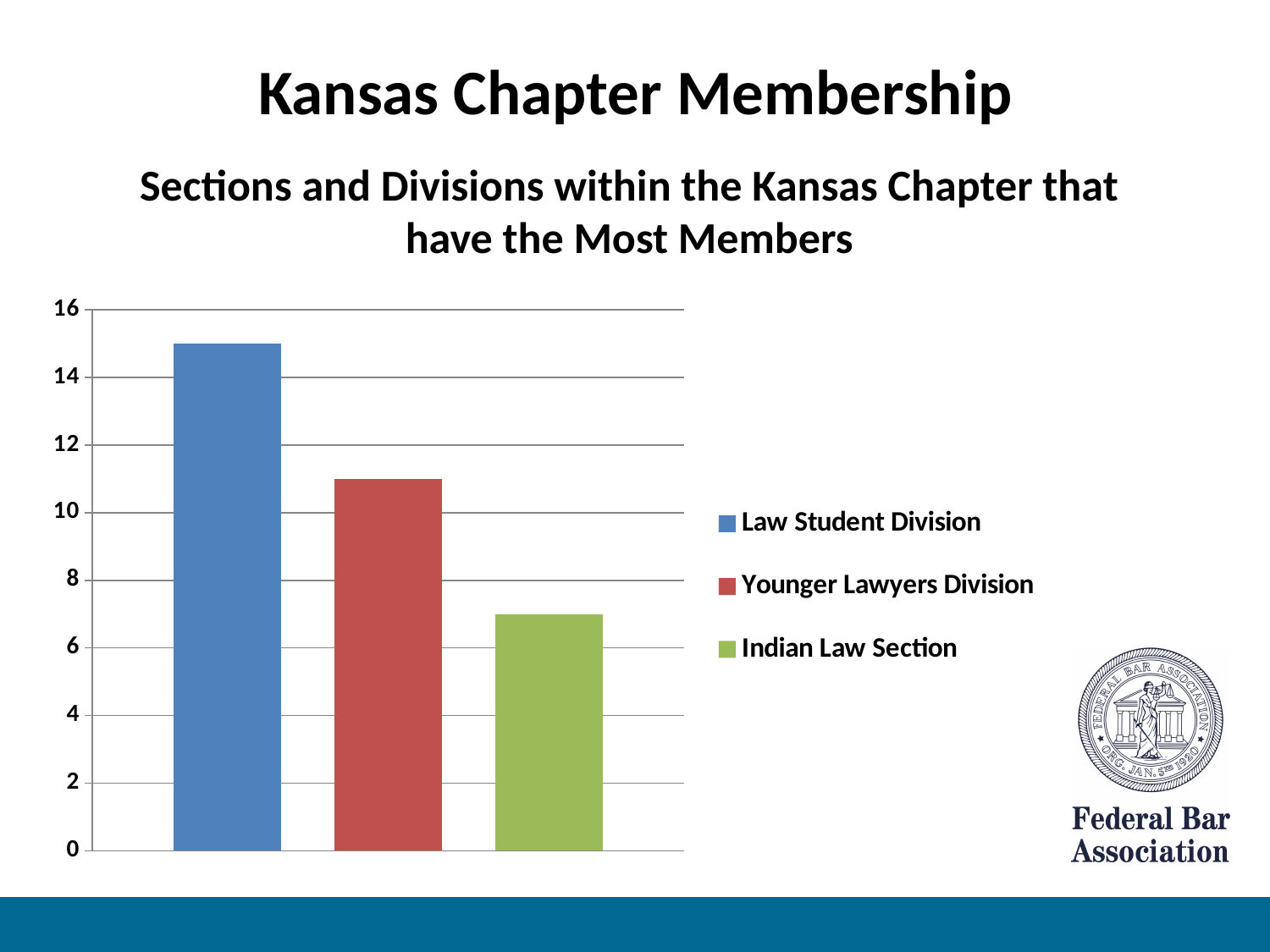
Is the value for Indian Law Section greater or less than 6? greater What colour is the bar for Younger Lawyers Division? red Is the value for Indian Law Section greater or less than 8? less What kind of chart is shown on the slide? bar chart Do the bar values rise or fall from left to right across the chart? fall Which section or division has the highest bar in the chart? Law Student Division How many entries does the chart legend list? 3 Is the value for Younger Lawyers Division greater or less than 12? less Which is larger, the value for Younger Lawyers Division or the value for Indian Law Section? Younger Lawyers Division How many bars are plotted in the chart? 3 Which section or division has the lowest bar in the chart? Indian Law Section